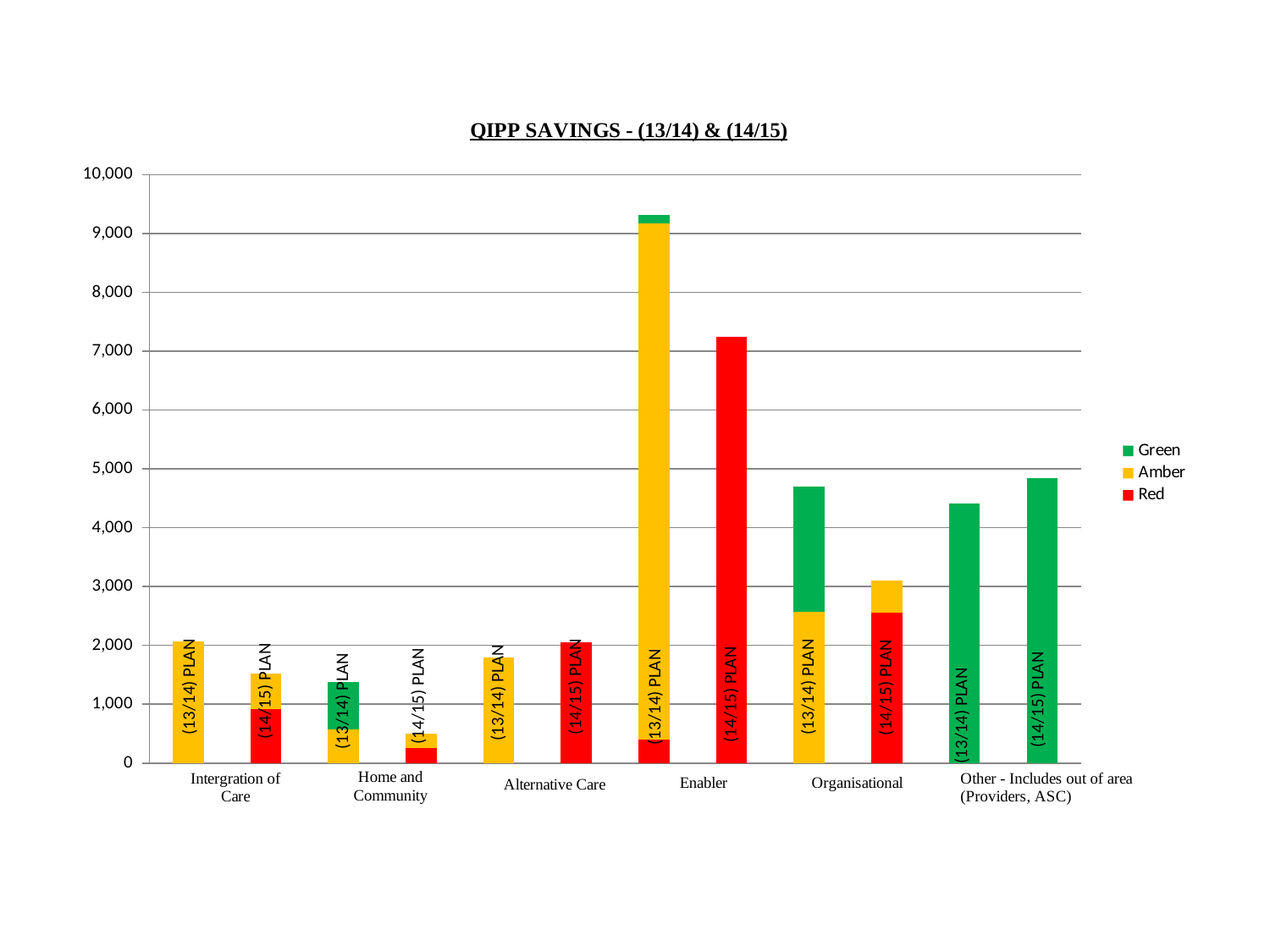
Which bar is the shortest in the chart? Home and Community (14/15) PLAN Which series makes up the entire bars for the Other - Includes out of area (Providers, ASC) category? Green What is the title of the chart? QIPP SAVINGS - (13/14) & (14/15) Is the total for the Intergration of Care (13/14) PLAN bar greater or less than 3,000? less Is the total for the Enabler (14/15) PLAN bar greater or less than 6,000? greater How many series does the legend list? 3 Is the total for the Enabler (13/14) PLAN bar greater or less than 9,000? greater For Other - Includes out of area (Providers, ASC), which bar is taller: (13/14) PLAN or (14/15) PLAN? (14/15) PLAN Which bar is the tallest in the chart? Enabler (13/14) PLAN What kind of chart is shown on the slide? bar chart How many categories are shown along the x axis? 6 For Organisational, which bar is taller: (13/14) PLAN or (14/15) PLAN? (13/14) PLAN